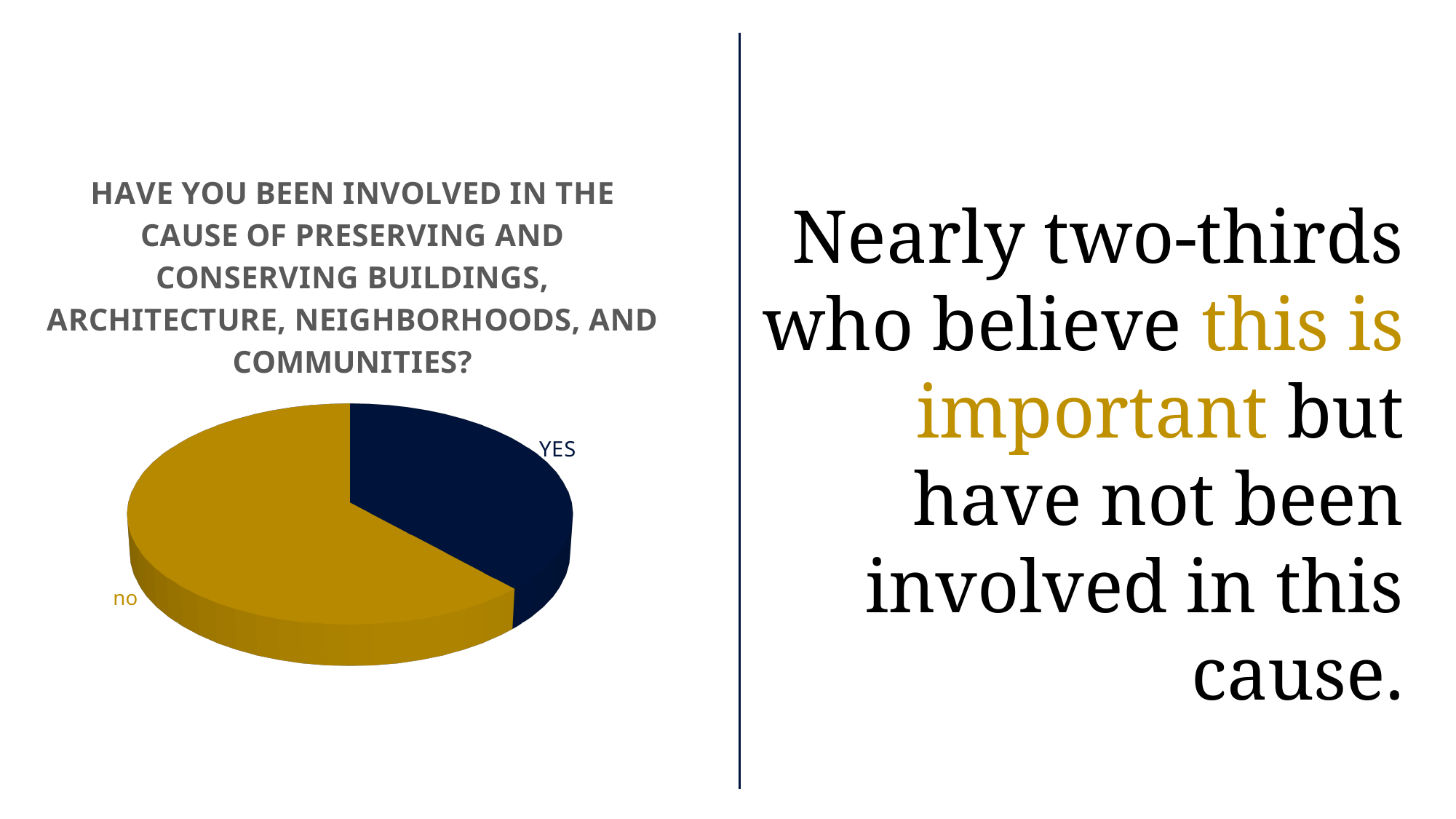
What colour is the no slice of the pie chart? gold How many slices does the pie chart have? 2 Does the no slice of the pie chart take up more or less than half of the pie? more Which slice of the pie chart is the largest? no Which slice of the pie chart is the smallest? YES Which slice is larger in the pie chart, YES or no? no What colour is the YES slice of the pie chart? navy blue What kind of chart is shown on the slide? pie chart